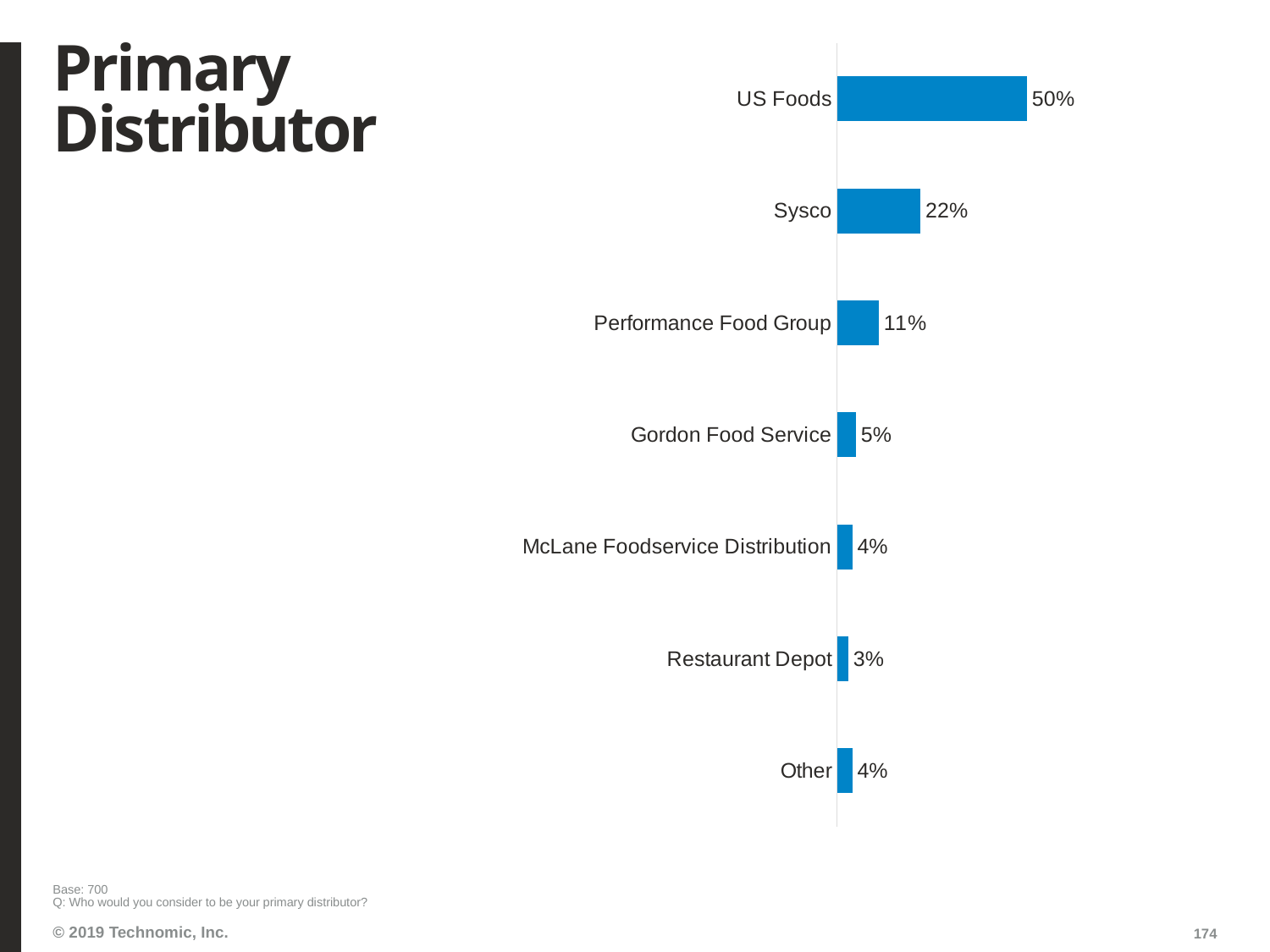
What is the value shown for Performance Food Group? 11% What is the title of the slide? Primary Distributor What kind of chart is shown on the slide? Bar chart What is the difference between the values for US Foods and Sysco? 28% What is the value shown for Gordon Food Service? 5% Which distributor has the lowest value on the chart? Restaurant Depot What percentage of respondents named US Foods as their primary distributor? 50% What is the value shown for Sysco? 22% Which distributor has the highest value on the chart? US Foods What is the difference between the values for Sysco and Performance Food Group? 11% Which has a larger value, Gordon Food Service or McLane Foodservice Distribution? Gordon Food Service How many distributor categories are shown on the chart? 7